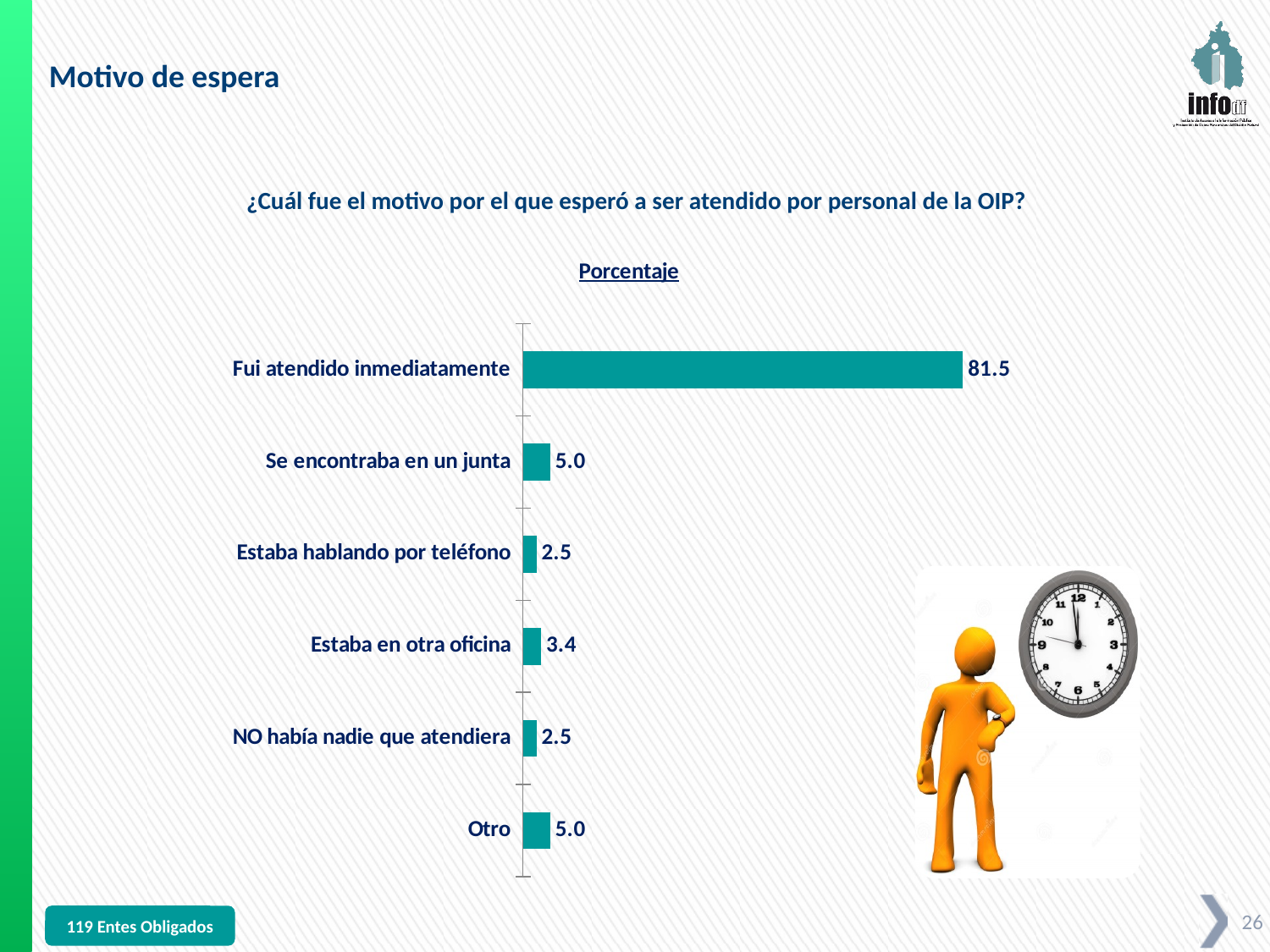
What is the value for "Se encontraba en un junta"? 5.0 What is the difference between the values for "Fui atendido inmediatamente" and "Se encontraba en un junta"? 76.5 What question is the chart answering, as shown in the heading above it? ¿Cuál fue el motivo por el que esperó a ser atendido por personal de la OIP? How many categories are shown in the chart? 6 What is the value for "Estaba en otra oficina"? 3.4 What is the value for "NO había nadie que atendiera"? 2.5 What kind of chart is shown on the slide? Bar chart What is the difference between the values for "Estaba en otra oficina" and "Estaba hablando por teléfono"? 0.9 What is the label shown above the chart? Porcentaje What is the value for "Fui atendido inmediatamente"? 81.5 Which is larger, the value for "Otro" or the value for "Estaba en otra oficina"? Otro Which category has the highest value? Fui atendido inmediatamente